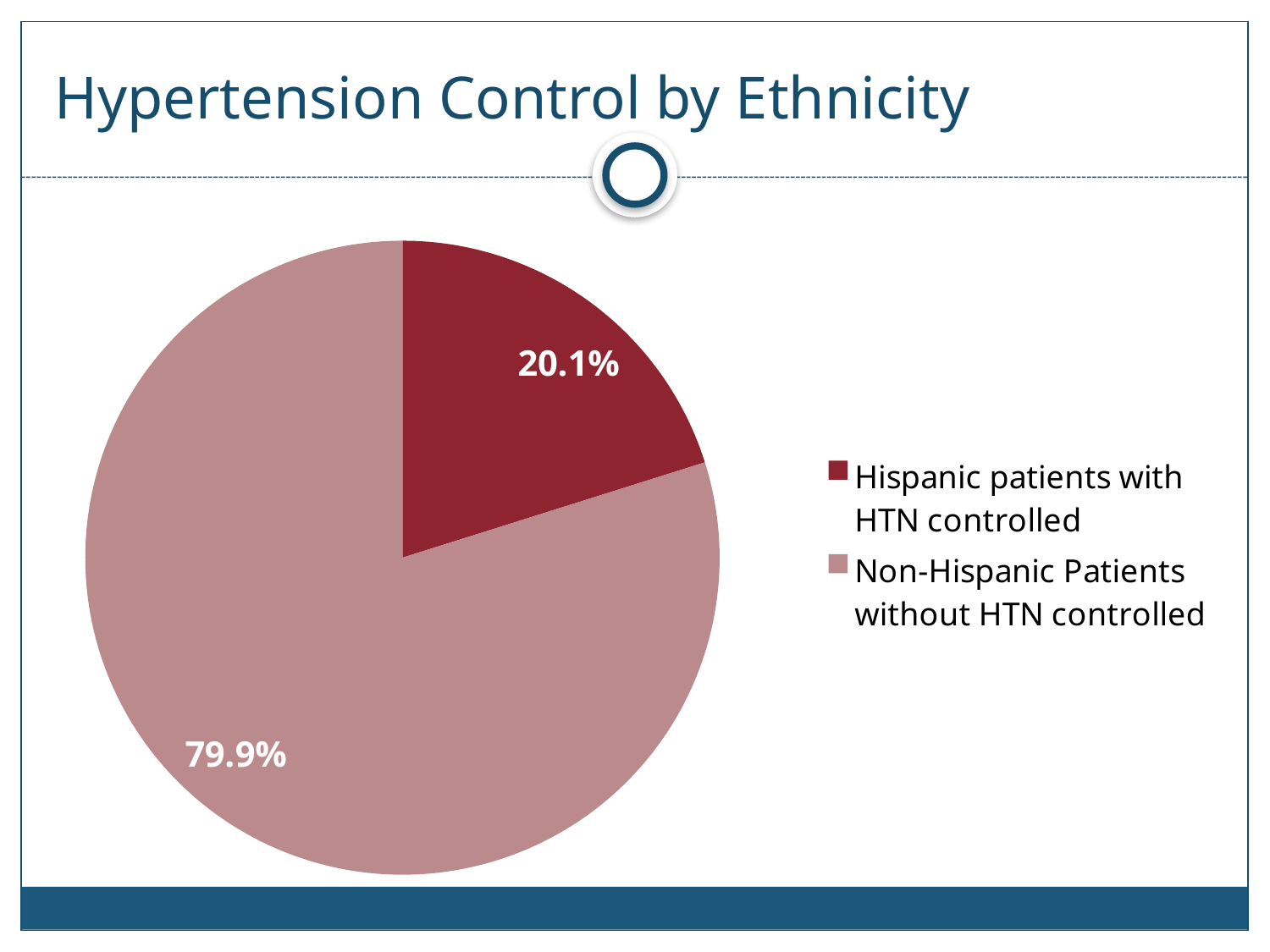
What share of the pie is labelled for Hispanic patients with HTN controlled? 20.1% What share of the pie is labelled for Non-Hispanic Patients without HTN controlled? 79.9% Which slice of the pie is the largest? Non-Hispanic Patients without HTN controlled Which legend entry is shown in the darker red colour? Hispanic patients with HTN controlled How many entries does the legend list? 2 What is the total of the two percentages shown on the pie chart? 100% What is the difference in percentage points between the Non-Hispanic Patients without HTN controlled slice and the Hispanic patients with HTN controlled slice? 59.8 Which slice of the pie is the smallest? Hispanic patients with HTN controlled Which is larger: the slice for Hispanic patients with HTN controlled or the slice for Non-Hispanic Patients without HTN controlled? Non-Hispanic Patients without HTN controlled How many slices does the pie chart have? 2 What is the title of the slide containing the pie chart? Hypertension Control by Ethnicity What kind of chart is shown on the slide? pie chart